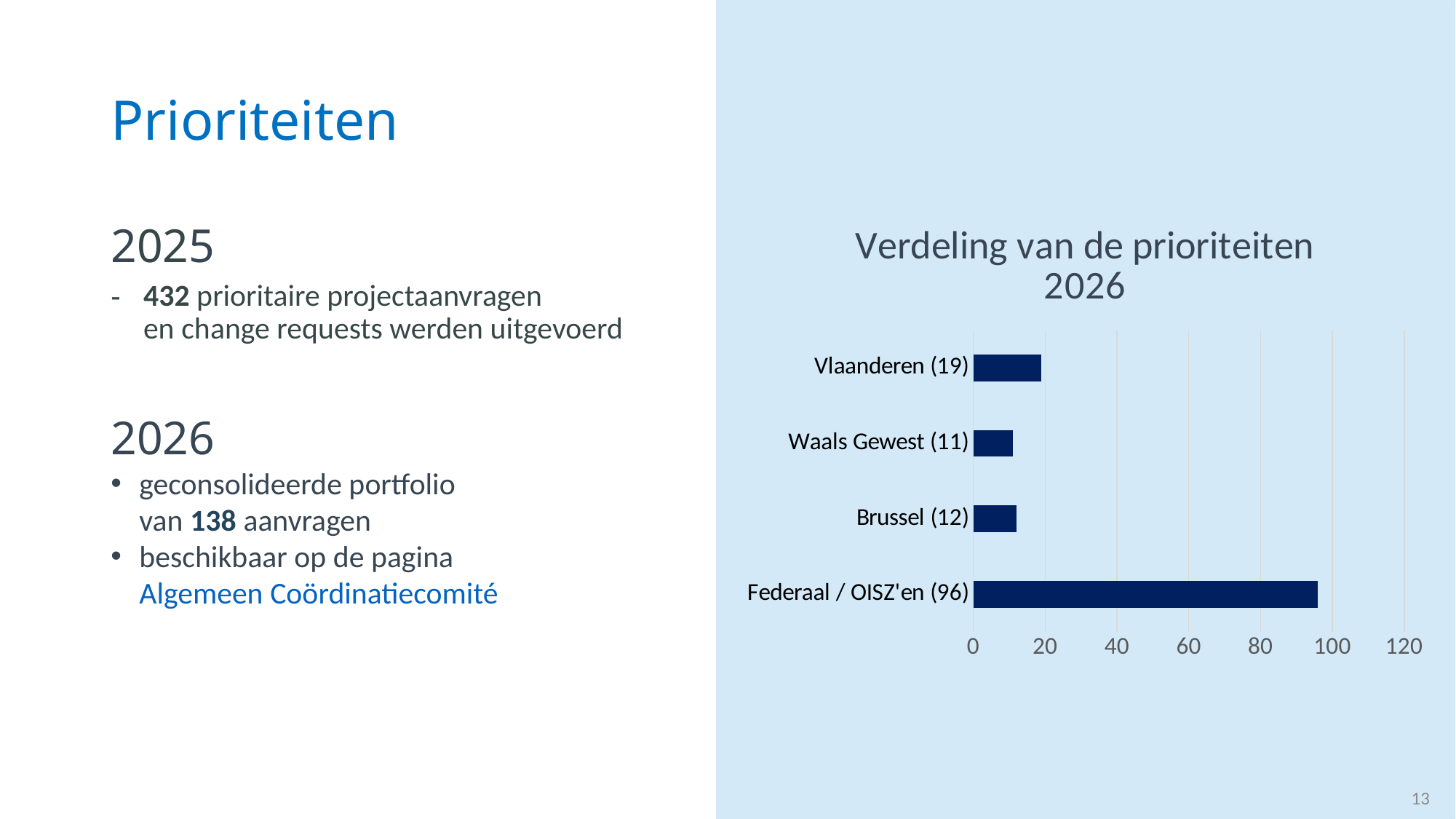
What is the value for Federaal / OISZ'en in the chart? 96 What is the difference between the values for Brussel and Waals Gewest? 1 Which category has the lowest value in the chart? Waals Gewest What is the difference between the values for Federaal / OISZ'en and Vlaanderen? 77 How many categories are shown in the chart? 4 What is the title of the chart? Verdeling van de prioriteiten 2026 What is the value for Vlaanderen in the chart? 19 What is the value for Waals Gewest in the chart? 11 What kind of chart is shown on the slide? Bar chart Is the value for Federaal / OISZ'en greater or less than 80? greater Which category has the highest value in the chart? Federaal / OISZ'en Which is larger, the value for Vlaanderen or the value for Brussel? Vlaanderen